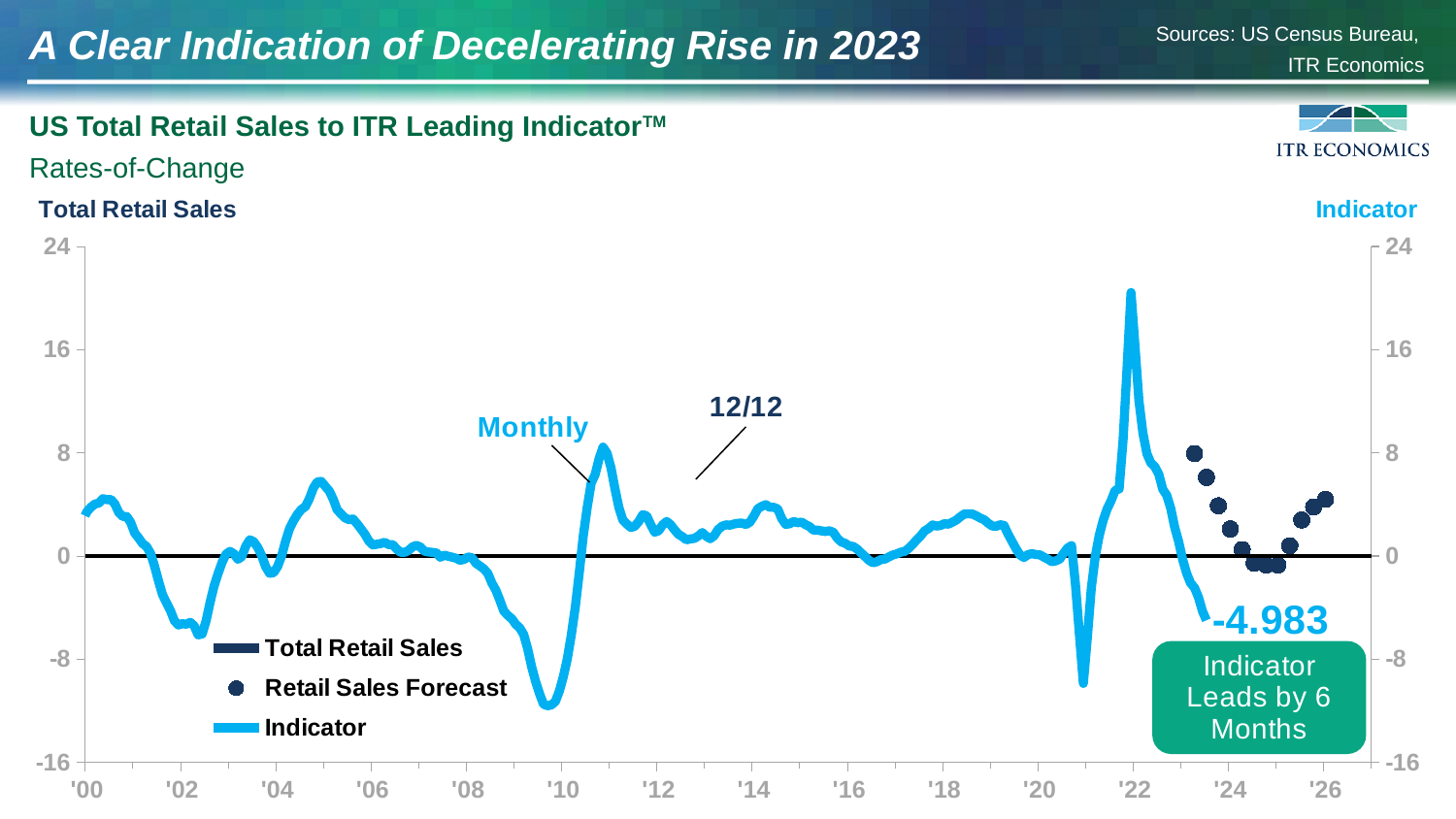
Does the Indicator line rise or fall between '22 and '23? fall Is the first Retail Sales Forecast dot around '23 greater or less than 4? greater Is the Indicator's lowest value around '09 greater or less than -8? less Is the Indicator's dip around '20 greater or less than -8? less How many year labels are shown on the x axis? 14 According to the callout box on the chart, by how many months does the Indicator lead? 6 Months Which is higher: the Indicator's peak around '22 or its peak around '11? the peak around '22 What kind of chart is shown on the slide? line chart What is the title of the chart? US Total Retail Sales to ITR Leading Indicator™ What is the latest value printed for the Indicator line? -4.983 How many series does the legend list? 3